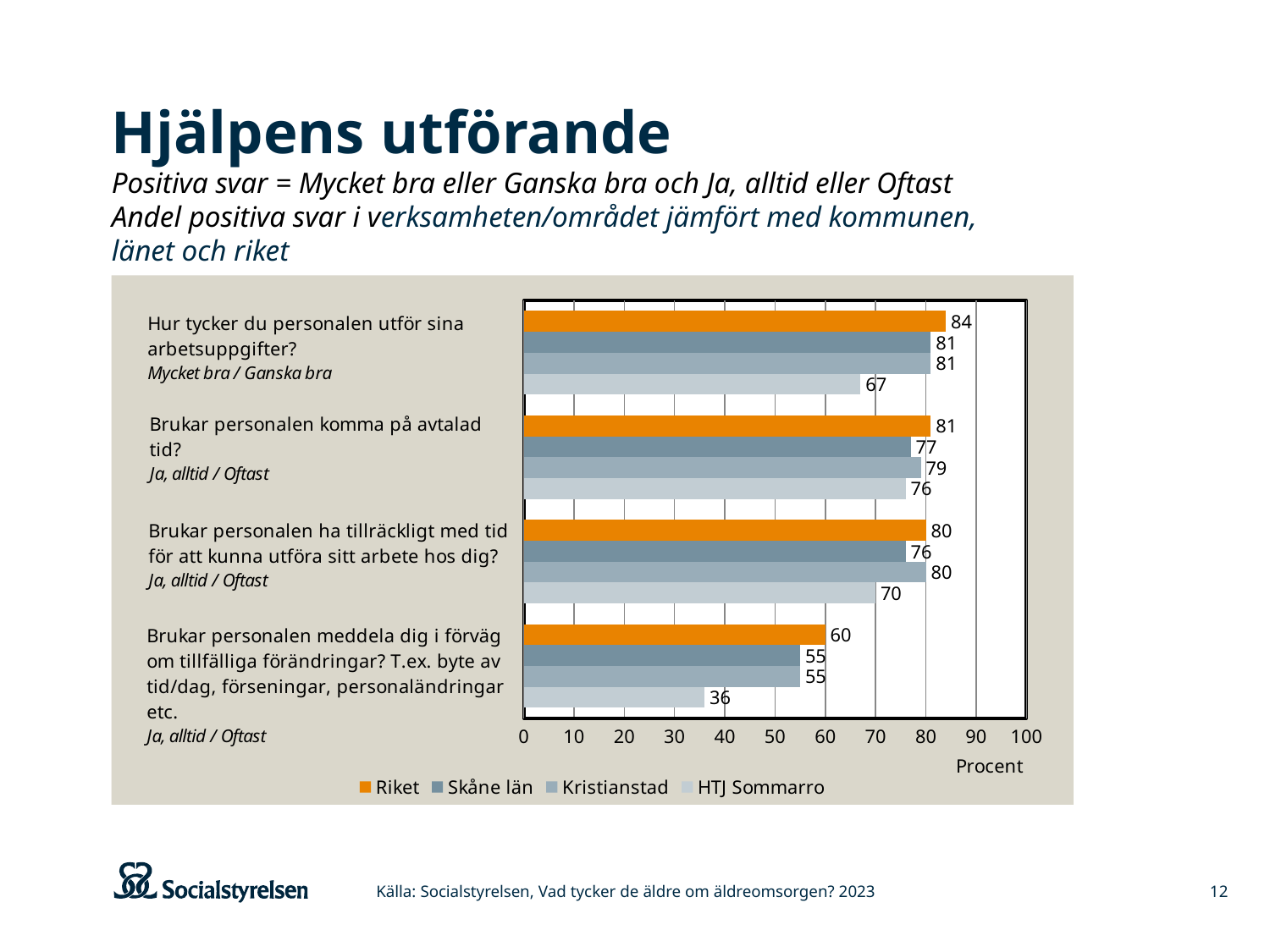
Which series has the lowest value on the question "Hur tycker du personalen utför sina arbetsuppgifter?"? HTJ Sommarro How many question categories are shown on the chart? 4 How many series does the legend list? 4 What is the difference between Riket and HTJ Sommarro on the question "Brukar personalen meddela dig i förväg om tillfälliga förändringar?"? 24 What is the difference between Riket and HTJ Sommarro on the question "Hur tycker du personalen utför sina arbetsuppgifter?"? 17 What is the value for HTJ Sommarro on the question "Brukar personalen meddela dig i förväg om tillfälliga förändringar?"? 36 What is the value for Kristianstad on the question "Brukar personalen komma på avtalad tid?"? 79 What kind of chart is shown on the slide? Bar chart Which is larger on the question "Brukar personalen ha tillräckligt med tid för att kunna utföra sitt arbete hos dig?": Kristianstad or HTJ Sommarro? Kristianstad What is the value for Skåne län on the question "Brukar personalen ha tillräckligt med tid för att kunna utföra sitt arbete hos dig?"? 76 What is the value for Riket on the question "Hur tycker du personalen utför sina arbetsuppgifter?"? 84 Which series has the highest value on the question "Brukar personalen meddela dig i förväg om tillfälliga förändringar?"? Riket